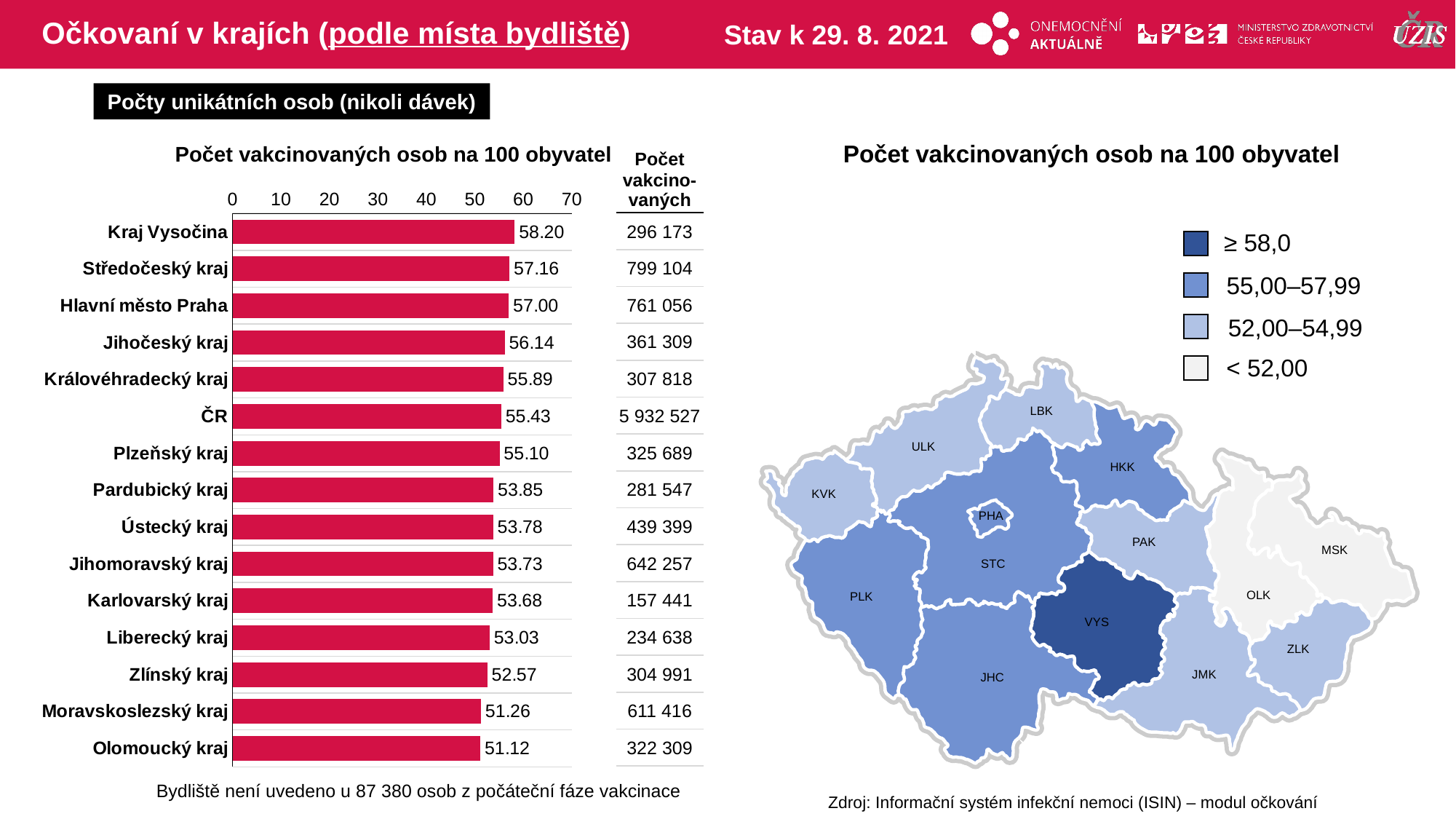
What kind of chart is shown on the left of the slide? bar chart In the bar chart, is the value for Moravskoslezský kraj greater or less than 60? less In the bar chart, what is the difference between the values for Kraj Vysočina and Olomoucký kraj? 7.08 In the bar chart, which is larger: the value for Jihočeský kraj or the value for Plzeňský kraj? Jihočeský kraj How many bars does the bar chart show? 15 In the bar chart, what is the value for ČR? 55.43 What is the title of the bar chart on the left? Počet vakcinovaných osob na 100 obyvatel In the bar chart, which category has the highest value? Kraj Vysočina In the bar chart, what is the value for Olomoucký kraj? 51.12 In the bar chart, do the values rise or fall going from the top bar to the bottom bar? fall In the bar chart, which category has the lowest value? Olomoucký kraj In the bar chart, what is the value for Kraj Vysočina? 58.20